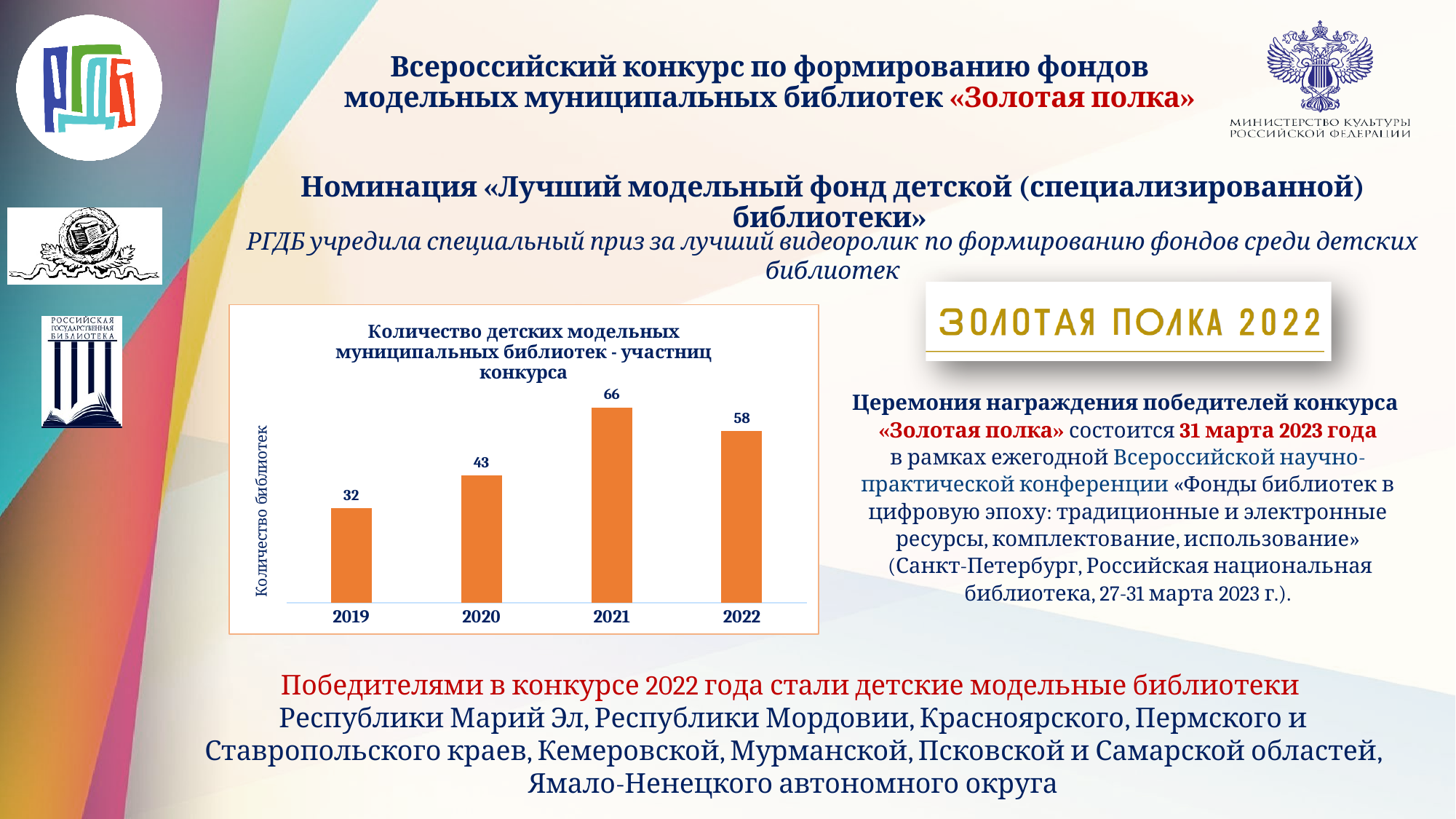
What is the value for 2019? 32 What is the label of the vertical axis? Количество библиотек What is the value for 2020? 43 Which year has the lowest value? 2019 What kind of chart is shown? Bar chart What is the difference between the values for 2020 and 2019? 11 What is the value for 2022? 58 What is the value for 2021? 66 How many years are shown on the x axis? 4 What is the difference between the values for 2021 and 2022? 8 Which year has the highest value? 2021 Which is larger, the value for 2020 or the value for 2022? 2022